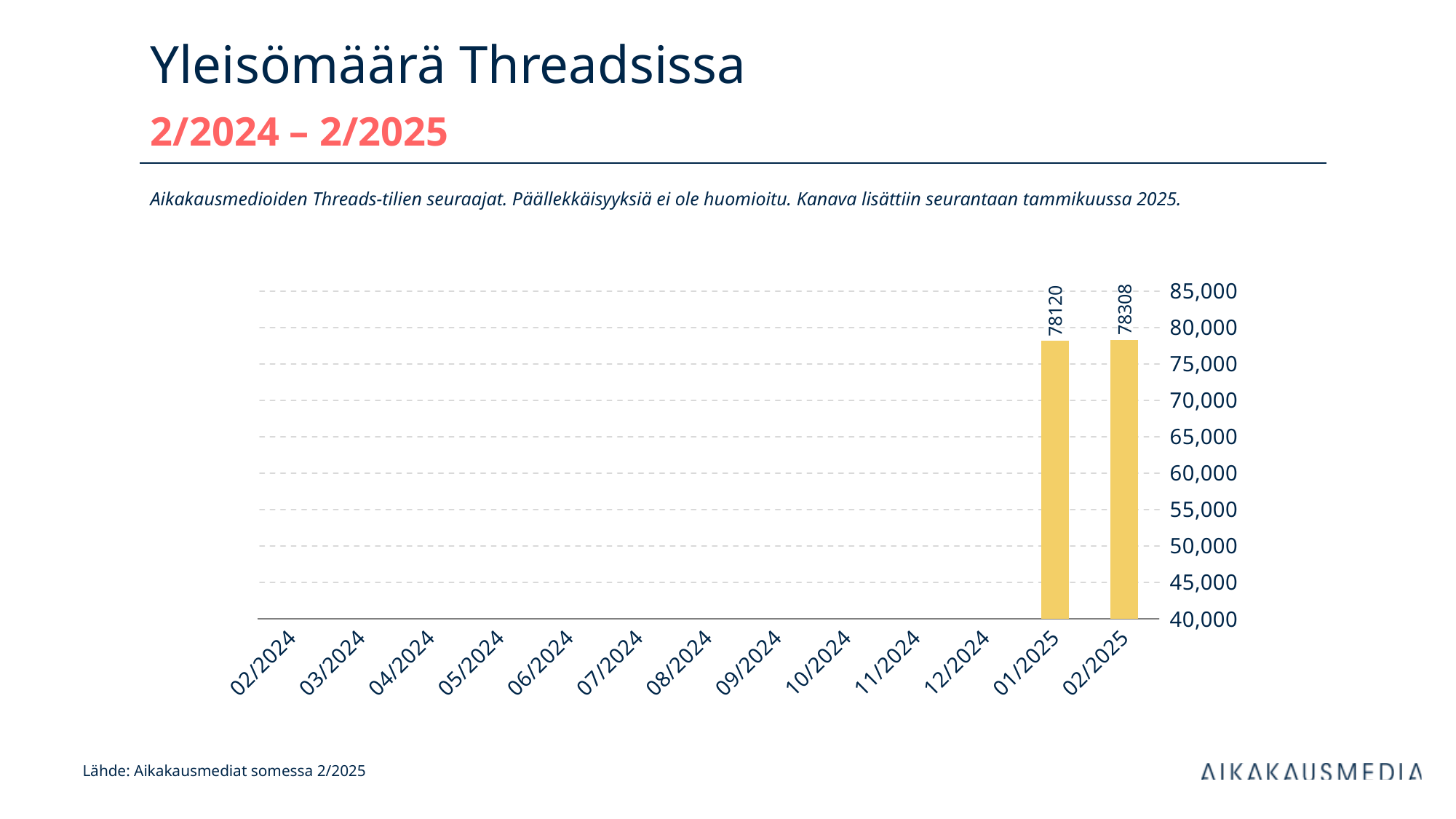
What is the value for 02/2025? 78308 What is the difference between the values for 02/2025 and 01/2025? 188 What is the value for 01/2025? 78120 How many months have a bar plotted on the chart? 2 Which is larger, the value for 01/2025 or the value for 02/2025? 02/2025 Is the value for 02/2025 greater or less than 80,000? less Which month has the highest value shown on the chart? 02/2025 What kind of chart is shown on the slide? bar chart Is the value for 01/2025 greater or less than 75,000? greater How many months are listed on the x axis? 13 What is the title of the slide? Yleisömäärä Threadsissa Does the value rise or fall from 01/2025 to 02/2025? rise